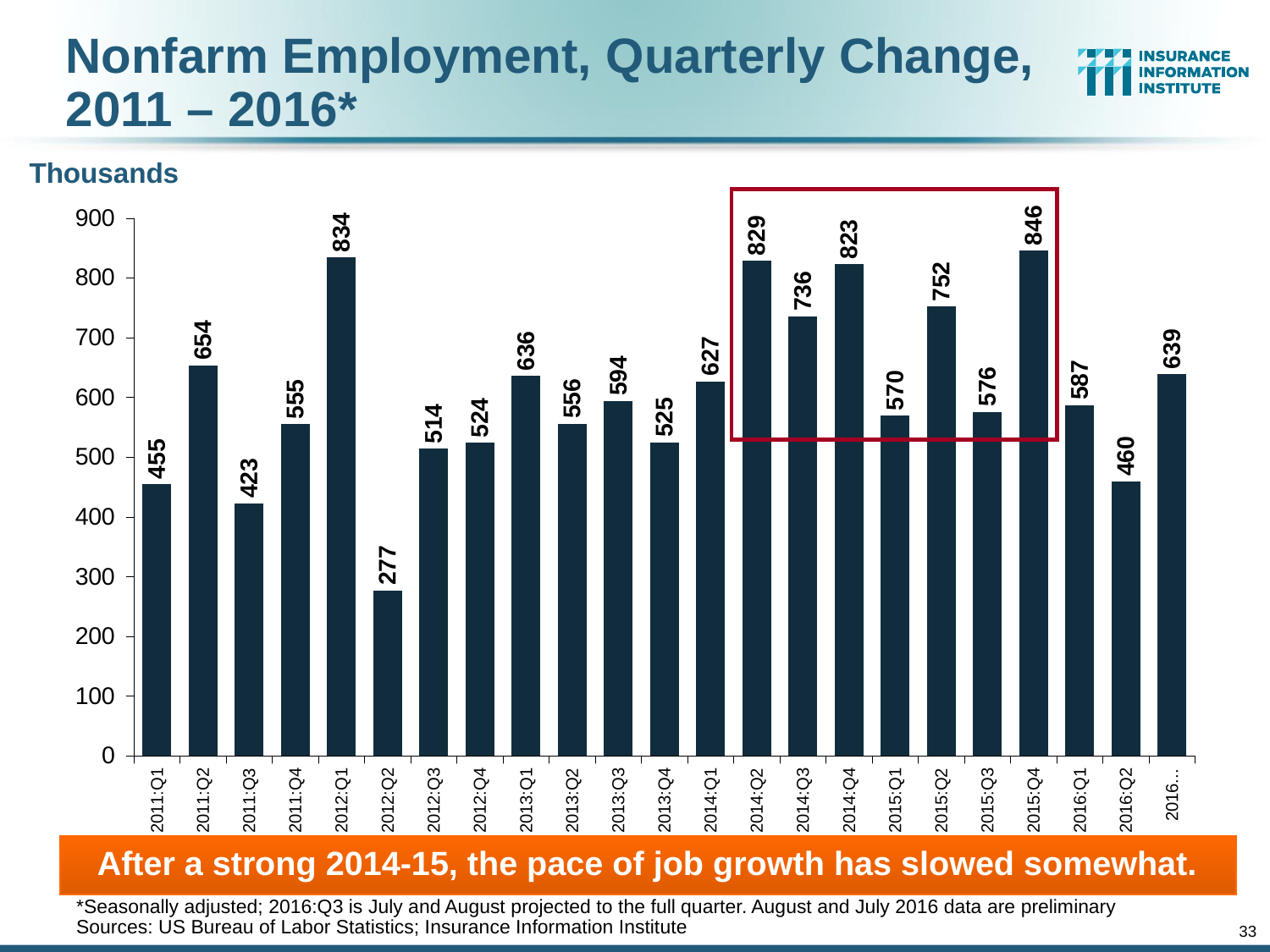
What kind of chart is shown on the slide? Bar chart Is the value for 2014:Q4 greater or less than 700? greater What is the difference between the values for 2011:Q2 and 2011:Q3? 231 Do the values rise or fall from 2015:Q4 to 2016:Q2? Fall What is the value for 2014:Q3? 736 Which quarter has the lowest value? 2012:Q2 What is the value for 2012:Q1? 834 What is the difference between the values for 2014:Q2 and 2015:Q1? 259 What unit is shown above the y axis of the chart? Thousands Which is larger, the value for 2013:Q1 or the value for 2015:Q2? 2015:Q2 Which quarter has the highest value? 2015:Q4 What is the value for 2016:Q2? 460